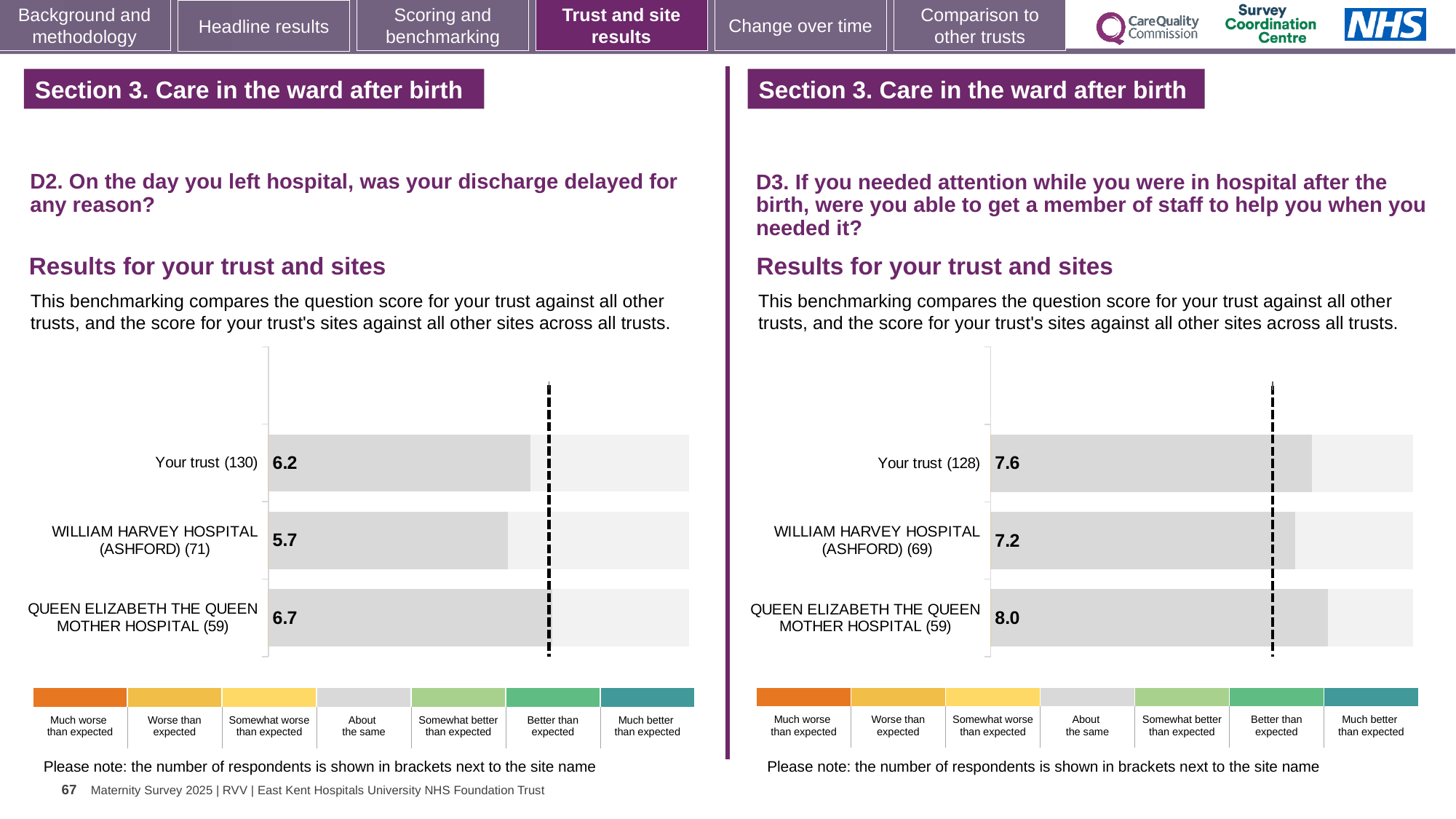
In the D2 chart on the left, what is the score for Your trust? 6.2 In the D3 chart on the right, what is the score for Your trust? 7.6 In the D2 chart on the left, what is the difference between the scores for QUEEN ELIZABETH THE QUEEN MOTHER HOSPITAL and WILLIAM HARVEY HOSPITAL (ASHFORD)? 1.0 In the D2 chart on the left, which site or trust has the highest score? QUEEN ELIZABETH THE QUEEN MOTHER HOSPITAL In the D3 chart on the right, which site or trust has the lowest score? WILLIAM HARVEY HOSPITAL (ASHFORD) In the D2 chart on the left, what is the score for WILLIAM HARVEY HOSPITAL (ASHFORD)? 5.7 How many bars are shown in the D3 chart on the right? 3 In the D3 chart on the right, what is the score for QUEEN ELIZABETH THE QUEEN MOTHER HOSPITAL? 8.0 In the D2 chart on the left, which has the larger score: Your trust or WILLIAM HARVEY HOSPITAL (ASHFORD)? Your trust What type of chart is the D2 chart on the left? Bar chart In the D3 chart on the right, what is the difference between the scores for Your trust and WILLIAM HARVEY HOSPITAL (ASHFORD)? 0.4 In the D3 chart on the right, how many respondents are shown in brackets for Your trust? 128